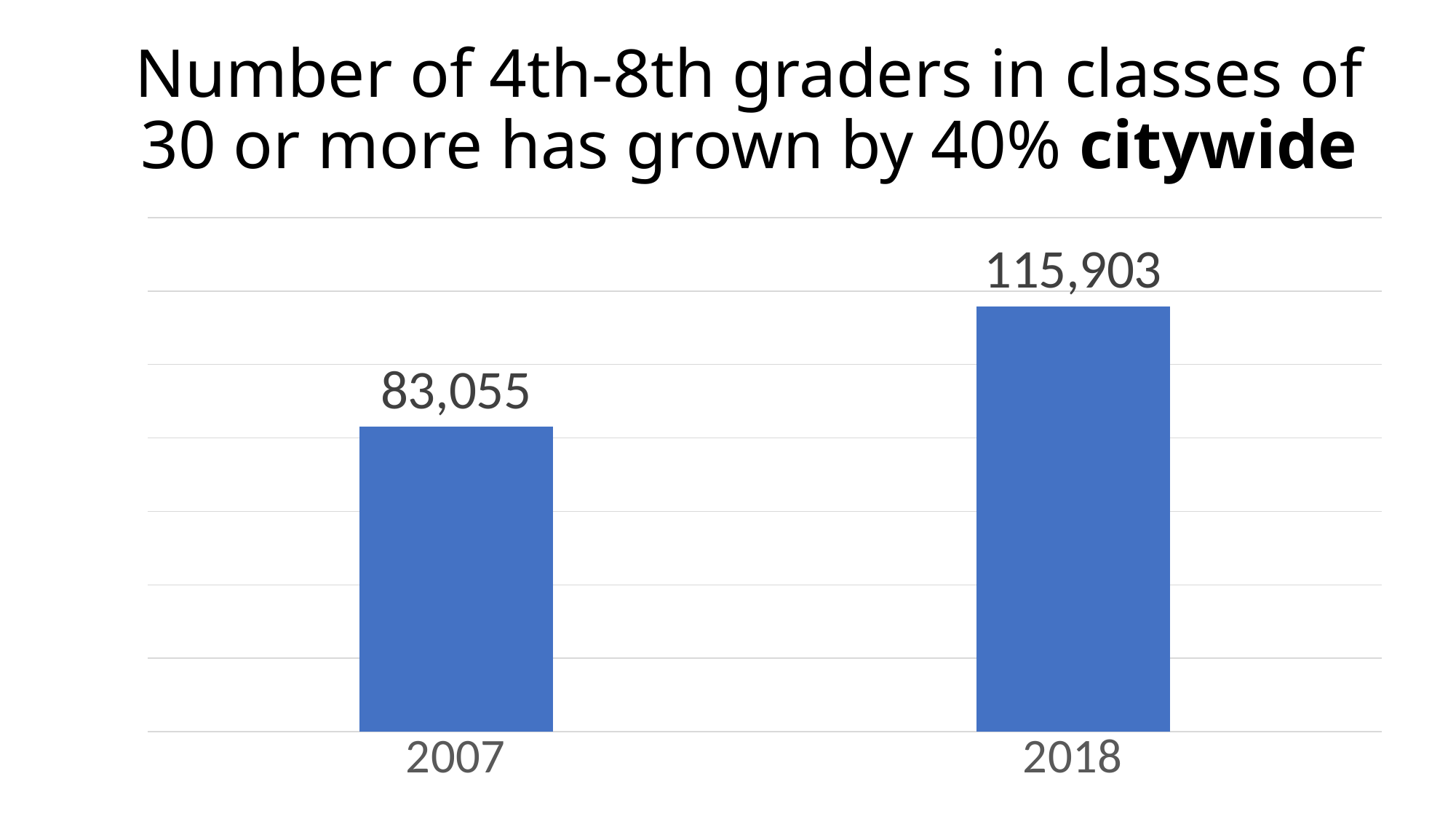
What is the difference between the values for 2018 and 2007? 32,848 How many bars are shown in the chart? 2 Do the values rise or fall from 2007 to 2018? Rise What kind of chart is shown on the slide? Bar chart Which year has the highest value? 2018 What is the combined total of the values for 2007 and 2018? 198,958 Which is larger, the value for 2007 or the value for 2018? 2018 What is the value for 2018? 115,903 Which year has the lowest value? 2007 What colour are the bars in the chart? Blue What is the title of the chart? Number of 4th-8th graders in classes of 30 or more has grown by 40% citywide What is the value for 2007? 83,055